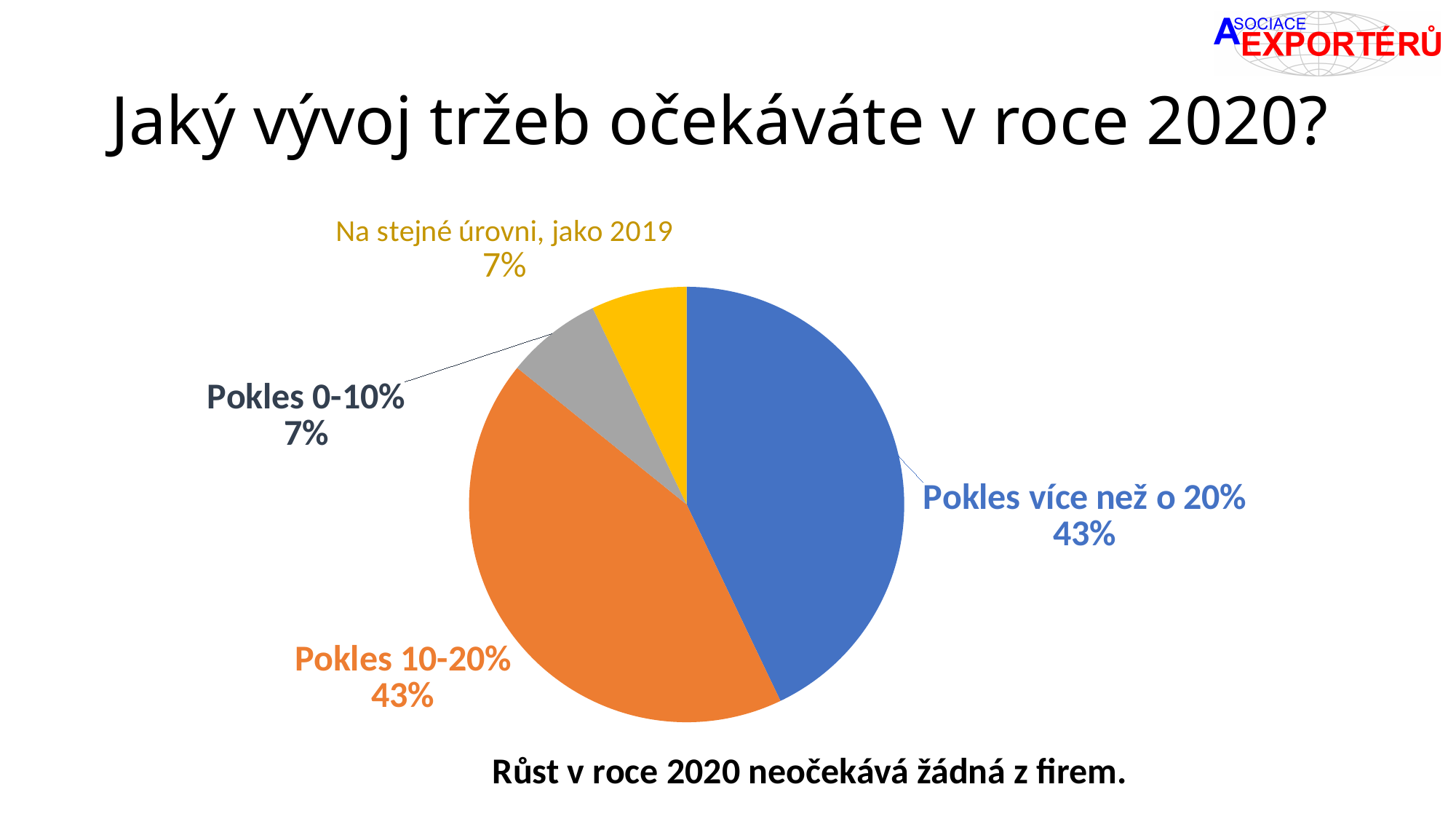
Which slice is larger: "Na stejné úrovni, jako 2019" or "Pokles více než o 20%"? Pokles více než o 20% What is the difference in percentage points between the "Pokles 10-20%" slice and the "Na stejné úrovni, jako 2019" slice? 36 percentage points What is the title of the slide containing the pie chart? Jaký vývoj tržeb očekáváte v roce 2020? What share of the pie does the slice "Pokles více než o 20%" represent? 43% What is the difference in percentage points between the "Pokles více než o 20%" slice and the "Pokles 0-10%" slice? 36 percentage points What colour is the slice labelled "Pokles 10-20%"? orange How many slices does the pie chart have? 4 What kind of chart is shown on the slide? pie chart Which slice is larger: "Pokles 10-20%" or "Pokles 0-10%"? Pokles 10-20% What value is shown for the slice "Na stejné úrovni, jako 2019"? 7% What value is shown for the slice "Pokles 0-10%"? 7% What share of the pie does the slice "Pokles 10-20%" represent? 43%